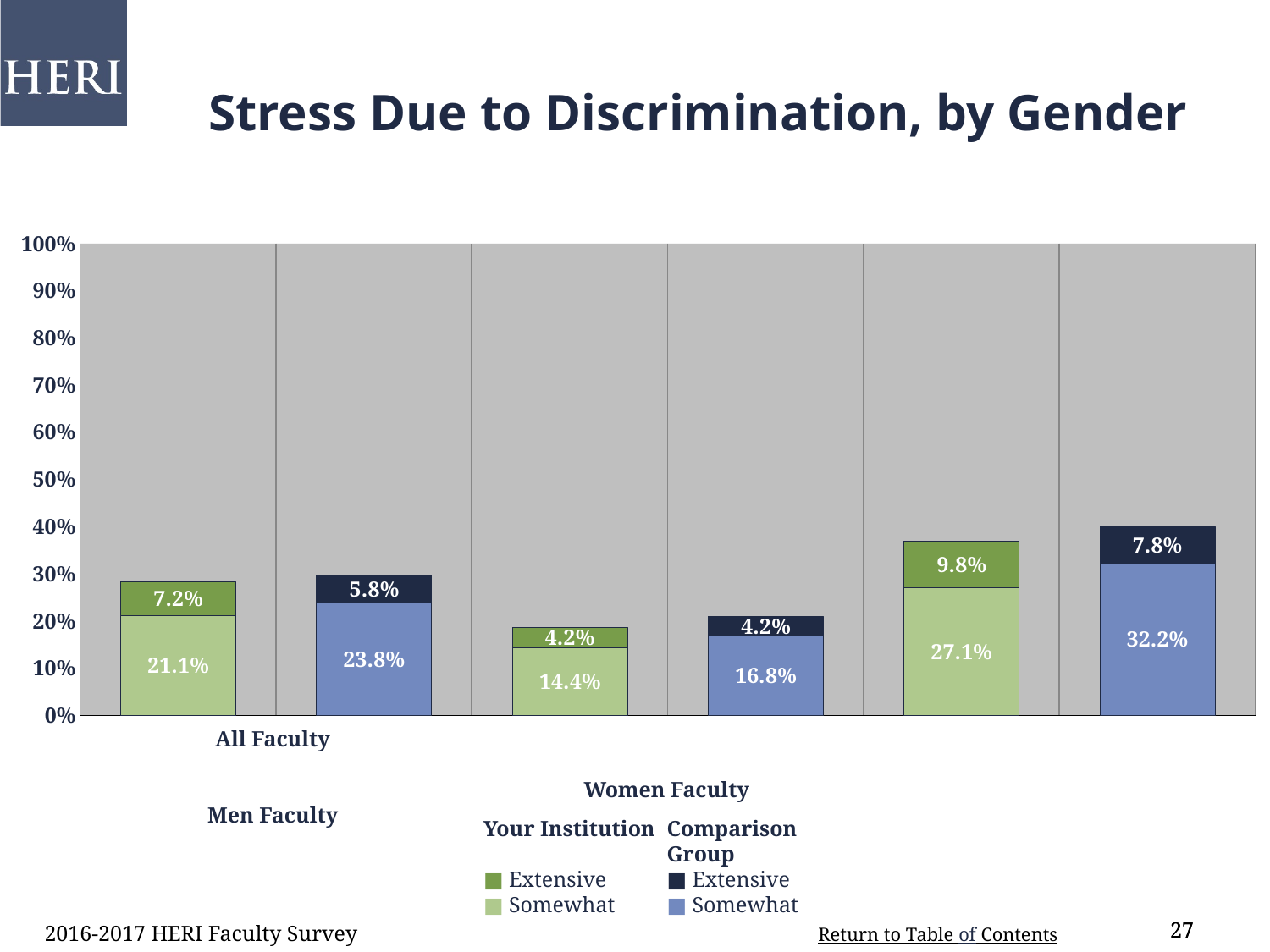
How many faculty groups are shown on the x axis? 3 What is the 'Extensive' value for the Comparison Group among All Faculty? 5.8% Which faculty group has the lowest 'Somewhat' value for Your Institution? Men Faculty What is the difference between the Comparison Group 'Somewhat' value for women faculty and for men faculty? 15.4% What is the total height of the stacked bar for men faculty in the Comparison Group? 21.0% How many entries does the legend list? 4 What is the total height of the stacked bar for women faculty at Your Institution? 36.9% What type of chart is shown on the slide? Stacked bar chart Which is larger: the 'Somewhat' value for All Faculty at Your Institution or in the Comparison Group? Comparison Group What is the 'Somewhat' value for men faculty in the Comparison Group? 16.8% What percentage of women faculty at Your Institution reported 'Somewhat' stress due to discrimination? 27.1% Which faculty group has the highest 'Extensive' value for Your Institution? Women Faculty